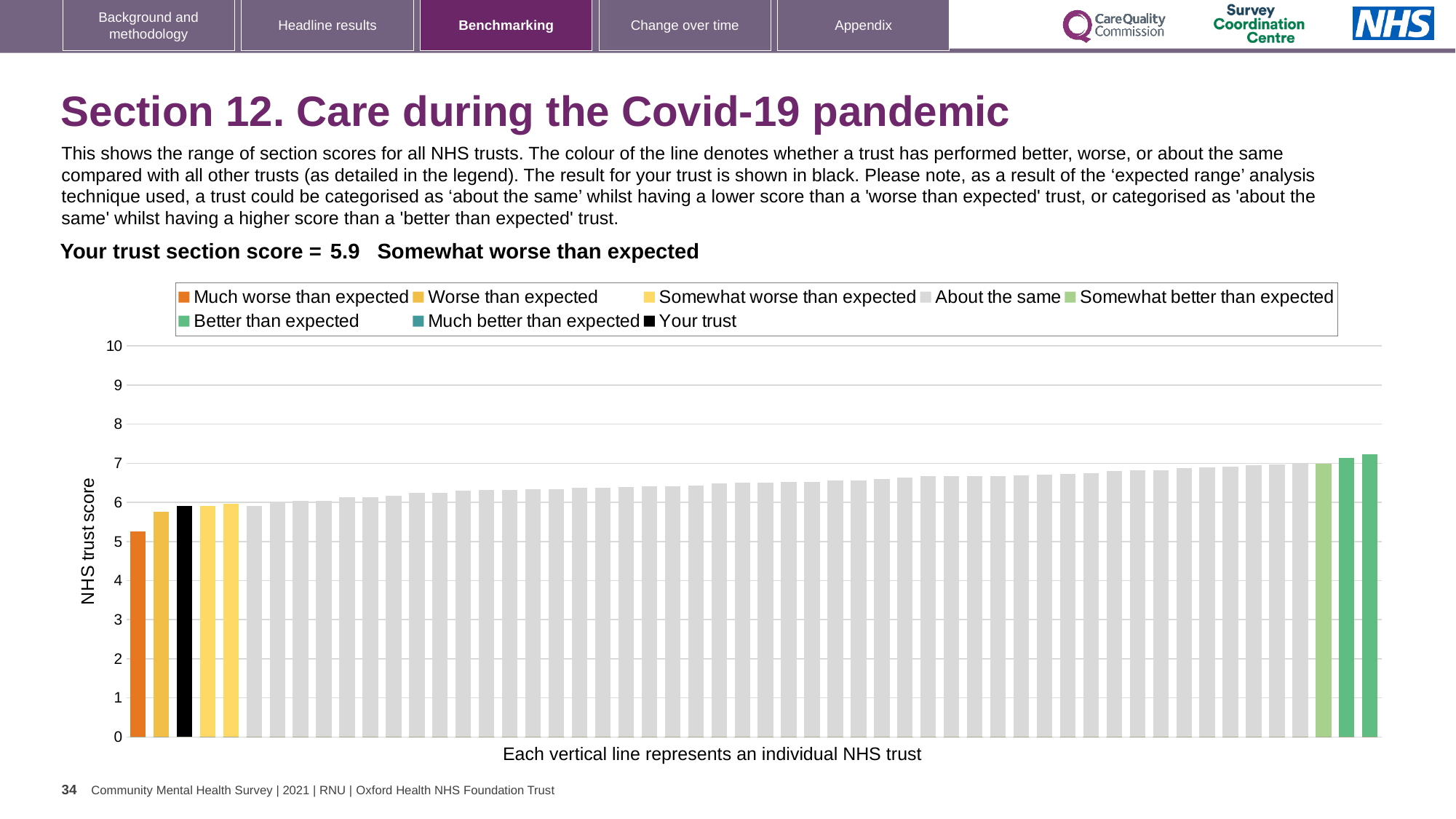
Is the value of the black 'Your trust' bar greater or less than 5? greater Which performance category is your trust placed in for this section? Somewhat worse than expected How many entries does the chart legend list? 8 Do the bar values rise or fall from left to right along the x axis? rise What is the section score for your trust shown on the slide? 5.9 Which is taller: the black 'Your trust' bar or the orange 'Much worse than expected' bar? Your trust Is the value of the leftmost (orange) bar greater or less than 6? less Which legend category does the shortest bar belong to? Much worse than expected What kind of chart is shown on the slide? Bar chart What is the label on the vertical axis of the chart? NHS trust score Which legend category does the tallest bar belong to? Better than expected Is the value of the rightmost bar greater or less than 7? greater